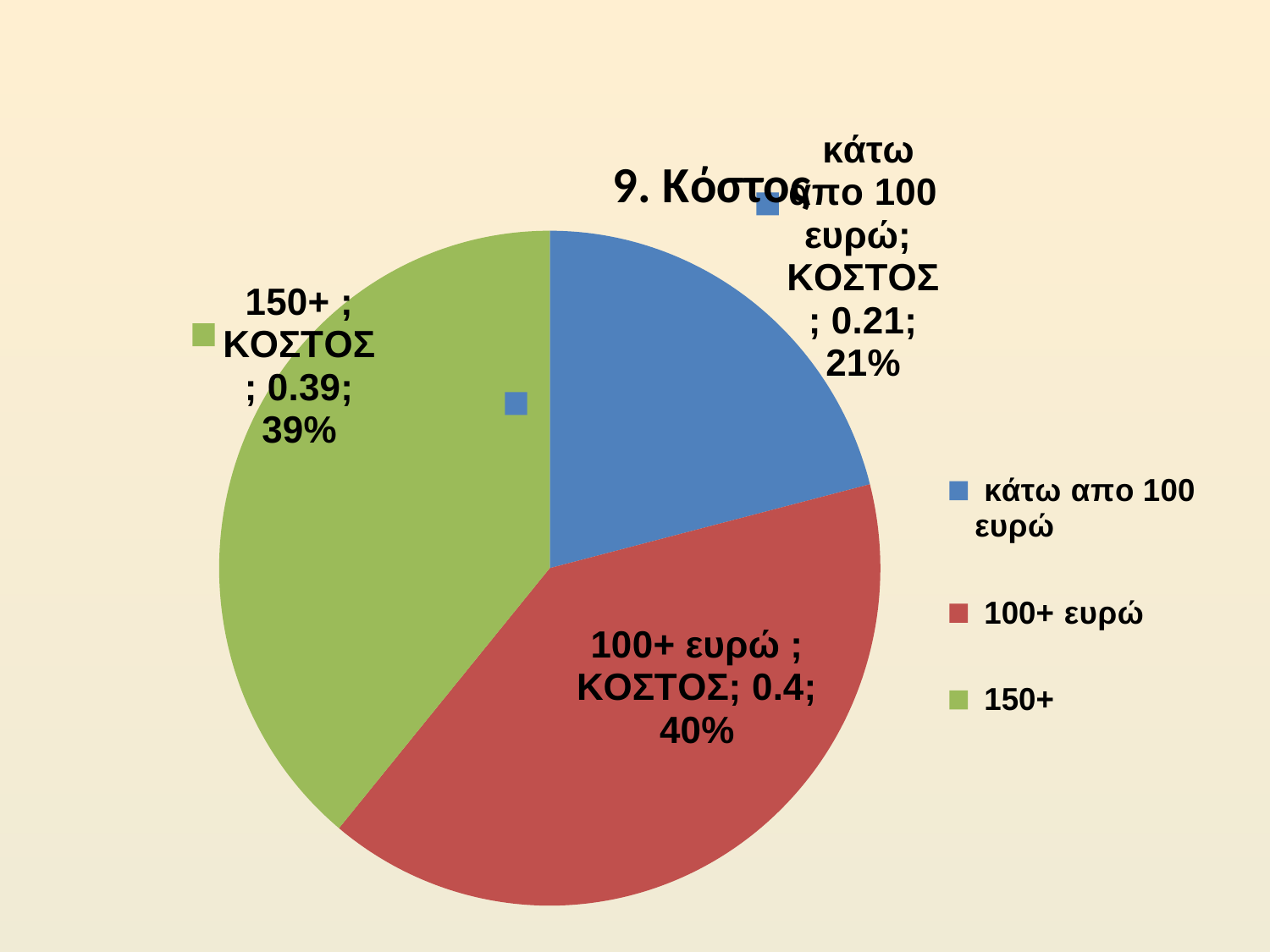
Which category has the smallest share of the pie? κάτω απο 100 ευρώ How many slices does the pie chart have? 3 What percentage of the pie does the '150+' slice represent? 39% What percentage of the pie does the '100+ ευρώ' slice represent? 40% Which category has the largest share of the pie? 100+ ευρώ What value is printed for the '150+' slice? 0.39 What kind of chart is shown on the slide? pie chart What is the difference in percentage points between the '100+ ευρώ' slice and the 'κάτω απο 100 ευρώ' slice? 19 What value is printed for the 'κάτω απο 100 ευρώ' slice? 0.21 What percentage of the pie does the 'κάτω απο 100 ευρώ' slice represent? 21% What is the title of the chart? 9. Κόστος How many entries does the legend list? 3